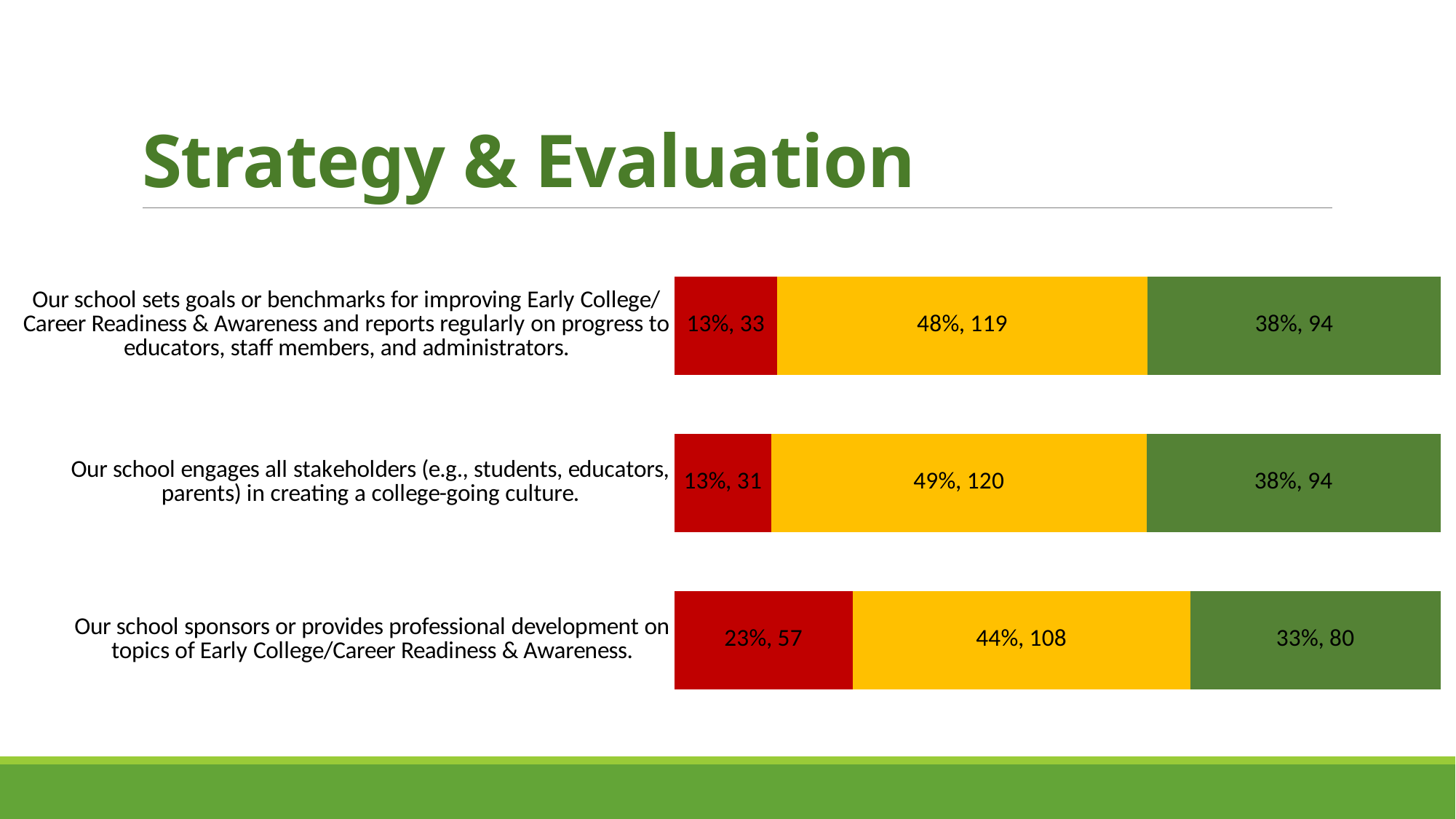
What is the label on the red segment for the statement about sponsoring or providing professional development? 23%, 57 Is the red segment larger for the statement about setting goals or benchmarks or for the statement about professional development? The statement about professional development What is the difference in the yellow segment counts between the statement about setting goals or benchmarks and the statement about professional development? 11 What kind of chart is shown on the slide? Stacked bar chart What is the total count across all three segments for the statement about setting goals or benchmarks? 246 What is the total count across all three segments for the statement about sponsoring or providing professional development? 245 Which statement has the smallest green segment? Our school sponsors or provides professional development on topics of Early College/Career Readiness & Awareness. How many statements (categories) are plotted in the chart? 3 Which statement has the largest red segment? Our school sponsors or provides professional development on topics of Early College/Career Readiness & Awareness. How many coloured segments make up each bar? 3 What is the label on the yellow segment for the statement about setting goals or benchmarks for improving Early College/Career Readiness & Awareness? 48%, 119 What is the label on the green segment for the statement about engaging all stakeholders in creating a college-going culture? 38%, 94